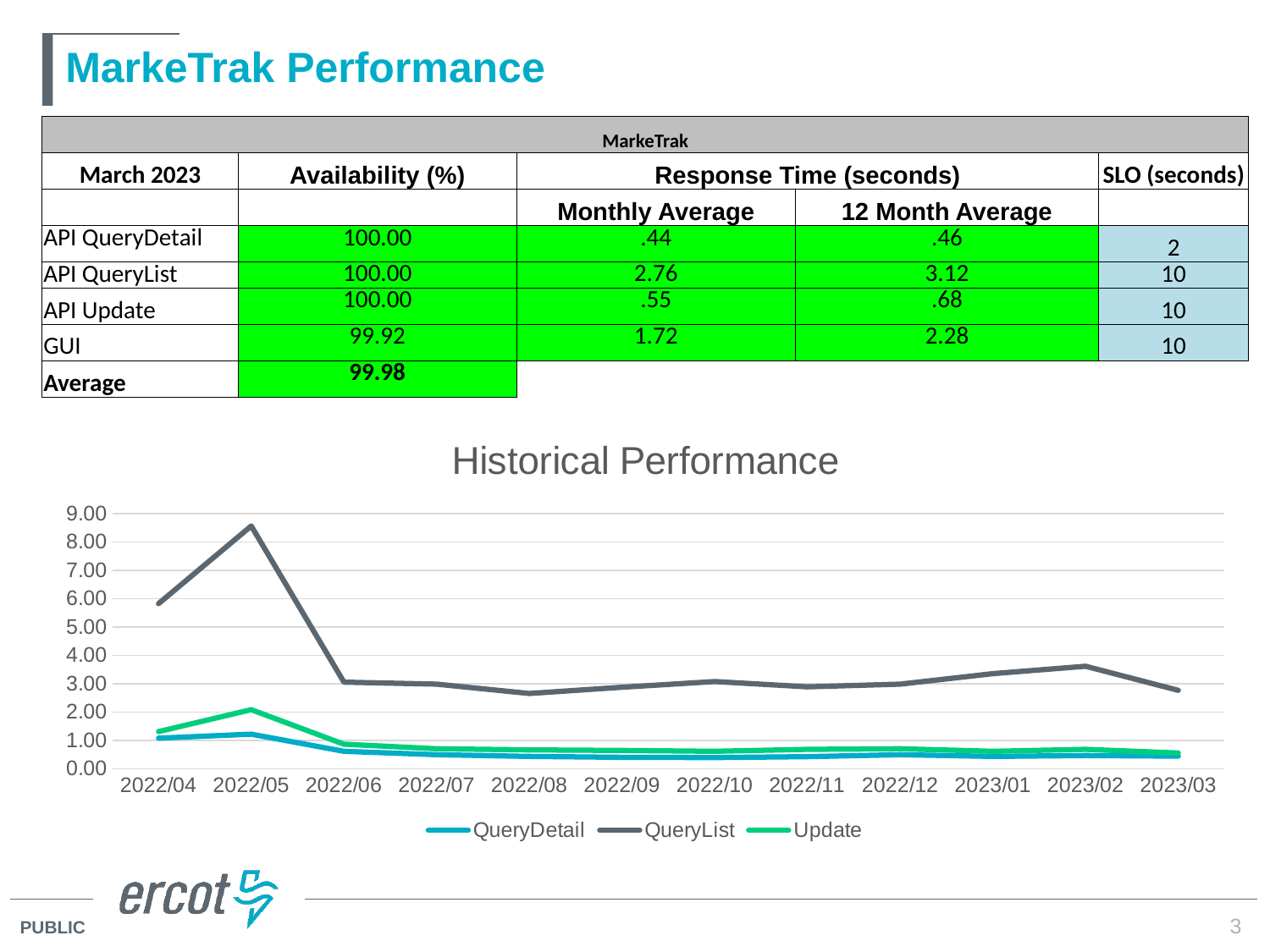
In the Historical Performance chart, which series has the highest values across the whole period? QueryList What is the title of the line chart on the slide? Historical Performance In the Historical Performance chart, is the QueryList value for 2022/04 greater or less than 5.00? greater In the Historical Performance chart, does the QueryList series rise or fall from 2022/05 to 2022/06? fall In the Historical Performance chart, is the QueryDetail value for 2023/03 greater or less than 1.00? less In the Historical Performance chart, is the QueryList value for 2022/05 greater or less than 8.00? greater What kind of chart is the Historical Performance chart? line chart How many series does the legend of the Historical Performance chart list? 3 In the Historical Performance chart, in which month does the QueryList series reach its highest value? 2022/05 How many months are plotted along the x axis of the Historical Performance chart? 12 In the Historical Performance chart, is the QueryList value larger at 2022/05 or at 2023/02? 2022/05